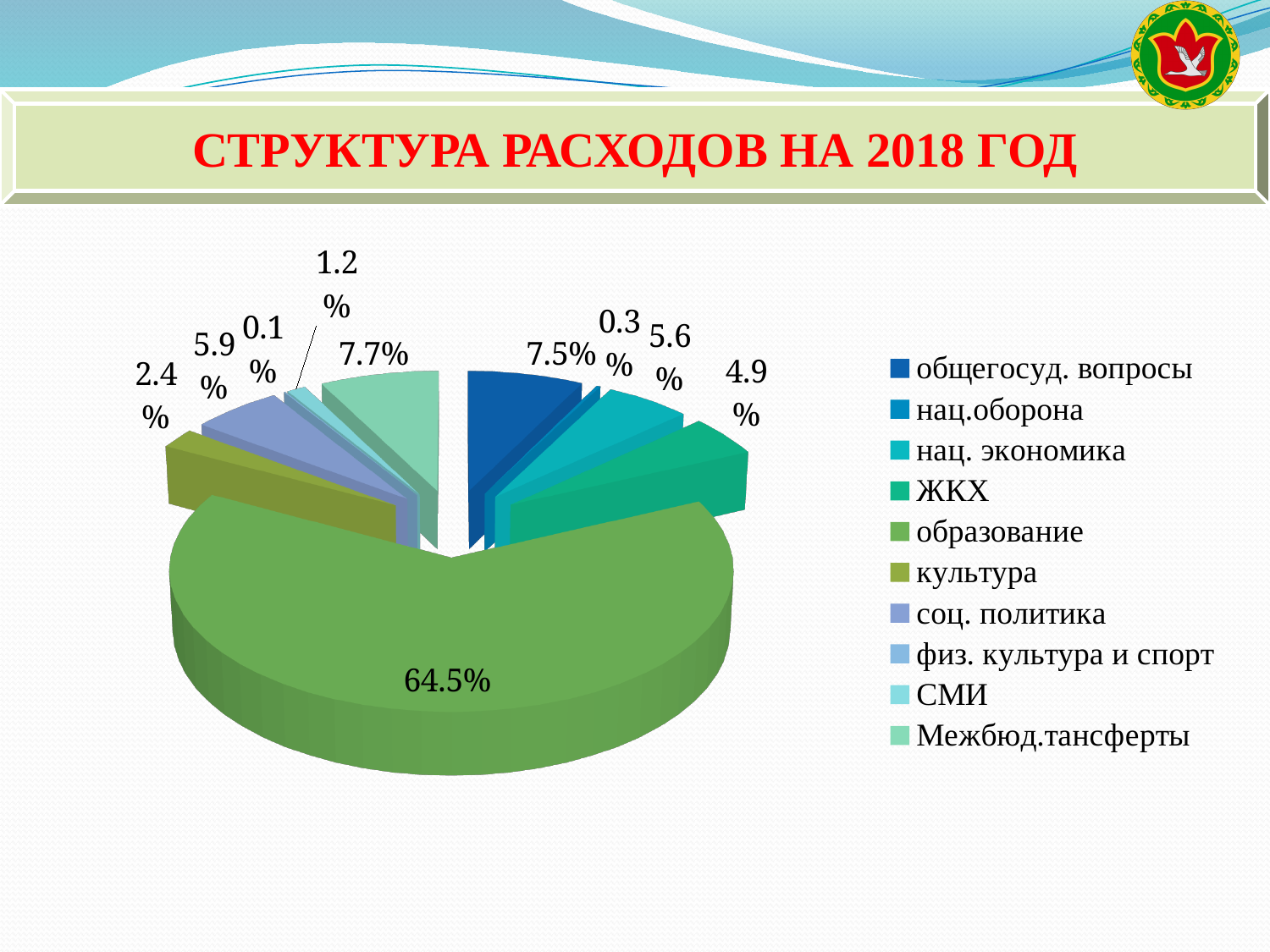
Which category is the smallest slice of the pie? физ. культура и спорт Which category has the largest slice of the pie? образование What is the difference between the share for образование and the share for общегосуд. вопросы? 57.0% What is the value shown for ЖКХ? 4.9% What is the value shown for культура? 2.4% How many categories does the legend of the pie chart list? 10 What share of the pie does образование take? 64.5% What kind of chart is shown on the slide? pie chart What is the title of the chart on the slide? СТРУКТУРА РАСХОДОВ НА 2018 ГОД Which is larger, the slice for Межбюд.тансферты or the slice for общегосуд. вопросы? Межбюд.тансферты What is the value shown for Межбюд.тансферты? 7.7% What is the value shown for общегосуд. вопросы? 7.5%